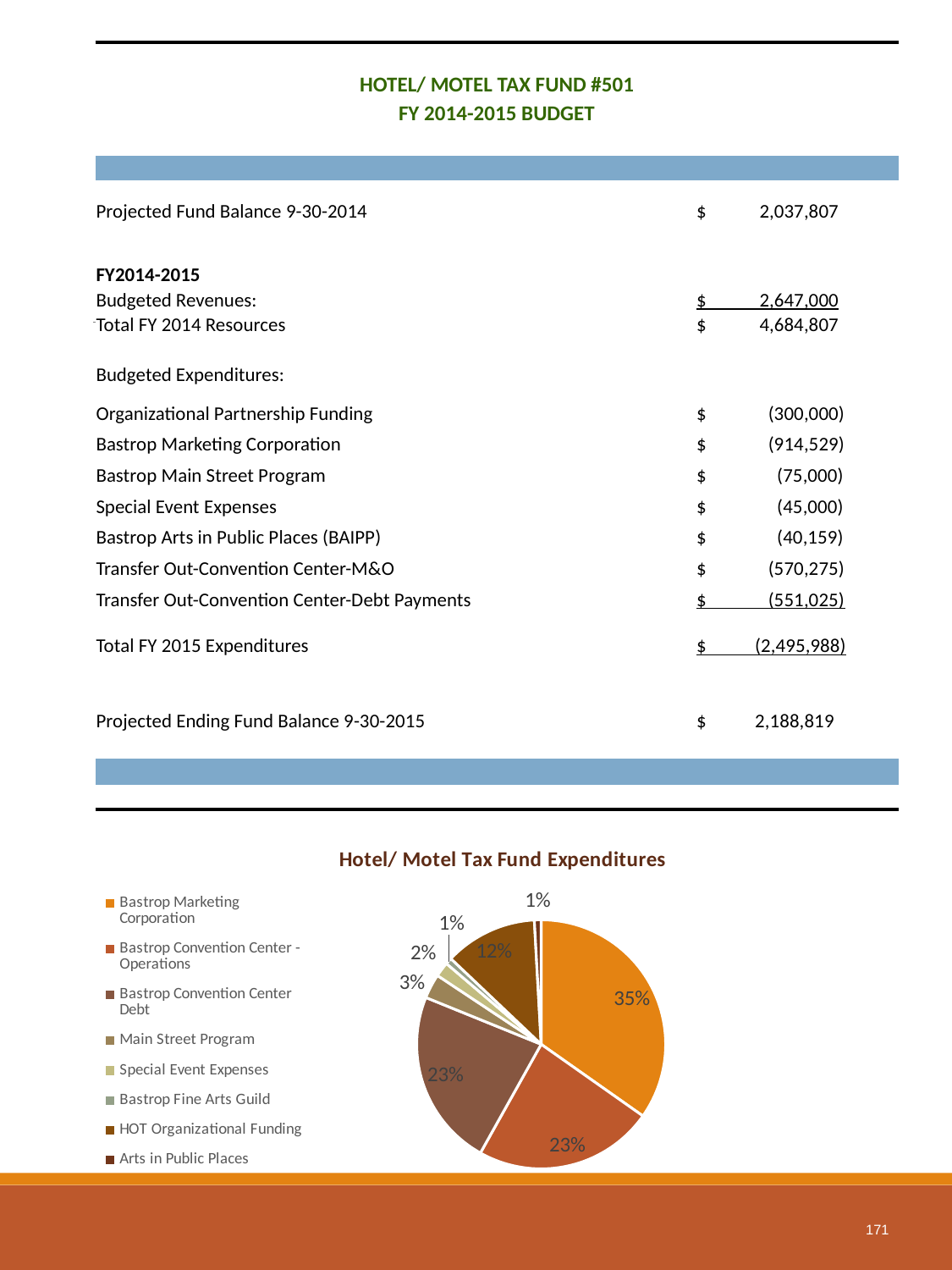
What is the difference in percentage points between the Bastrop Marketing Corporation slice and the Bastrop Convention Center - Operations slice? 12 Which category has the largest share of the pie chart? Bastrop Marketing Corporation What type of chart is shown under the title "Hotel/ Motel Tax Fund Expenditures"? pie chart What share of the pie chart does Main Street Program represent? 3% Which is larger in the pie chart, Bastrop Marketing Corporation or HOT Organizational Funding? Bastrop Marketing Corporation What is the difference in percentage points between the Bastrop Marketing Corporation slice and the HOT Organizational Funding slice? 23 What is the title of the chart at the bottom of the slide? Hotel/ Motel Tax Fund Expenditures What share of the pie chart does Bastrop Convention Center Debt represent? 23% What share of the pie chart does HOT Organizational Funding represent? 12% How many categories does the legend of the pie chart list? 8